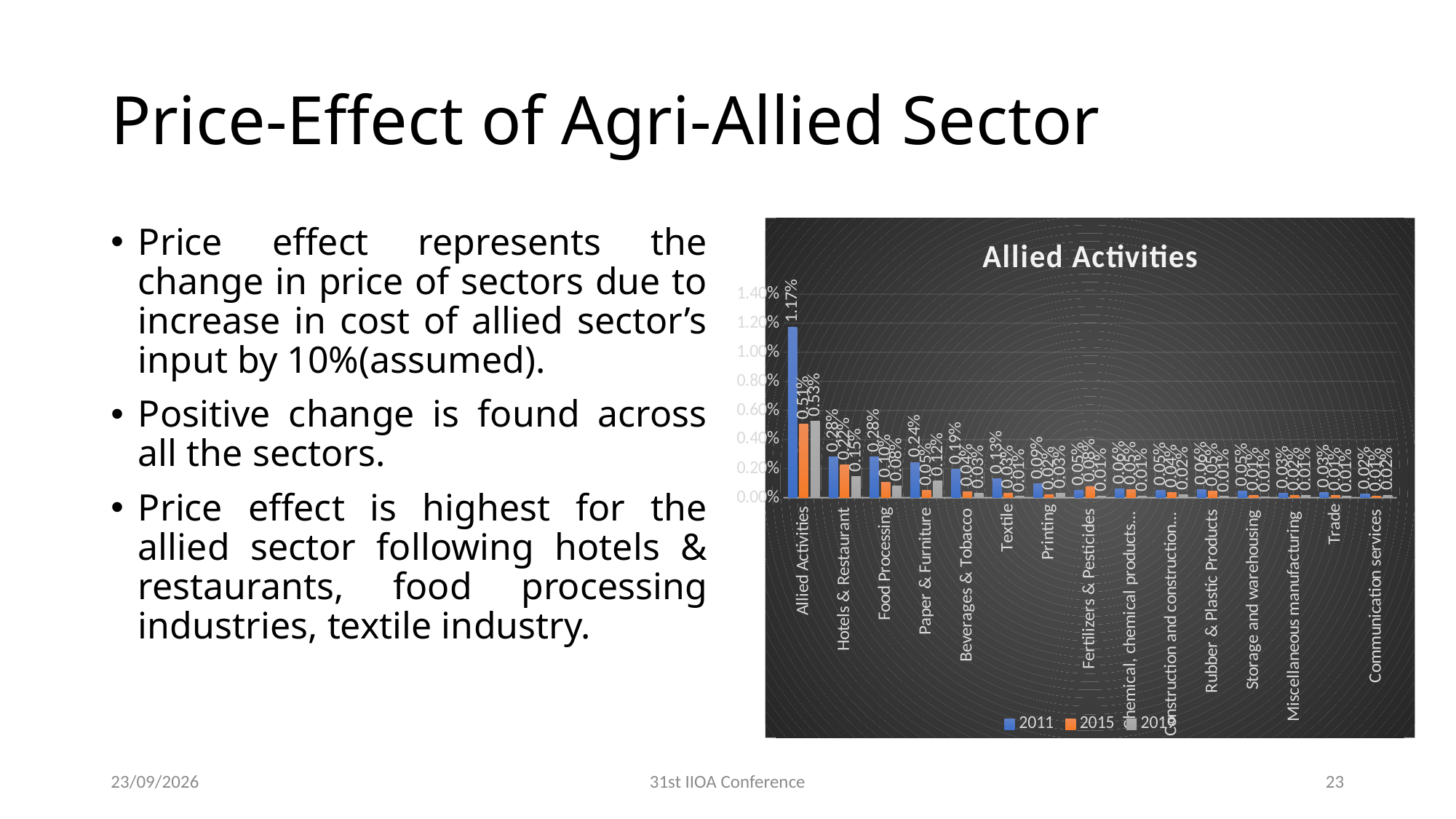
What is the title of the chart? Allied Activities What is the difference between the 2011 and 2015 values for Allied Activities? 0.66% How many categories are shown on the x axis of the chart? 15 Is the 2011 value for Allied Activities greater or less than 1.00%? greater Which category has the highest 2011 value? Allied Activities What is the 2011 value for Hotels & Restaurant? 0.28% Which is larger: the 2011 value for Allied Activities or the 2011 value for Hotels & Restaurant? Allied Activities Do the 2011 values generally rise or fall moving from left to right along the x axis? fall What kind of chart is shown on the slide? bar chart What is the 2011 value for Allied Activities? 1.17% How many series does the chart's legend list? 3 What is the 2015 value for Allied Activities? 0.51%